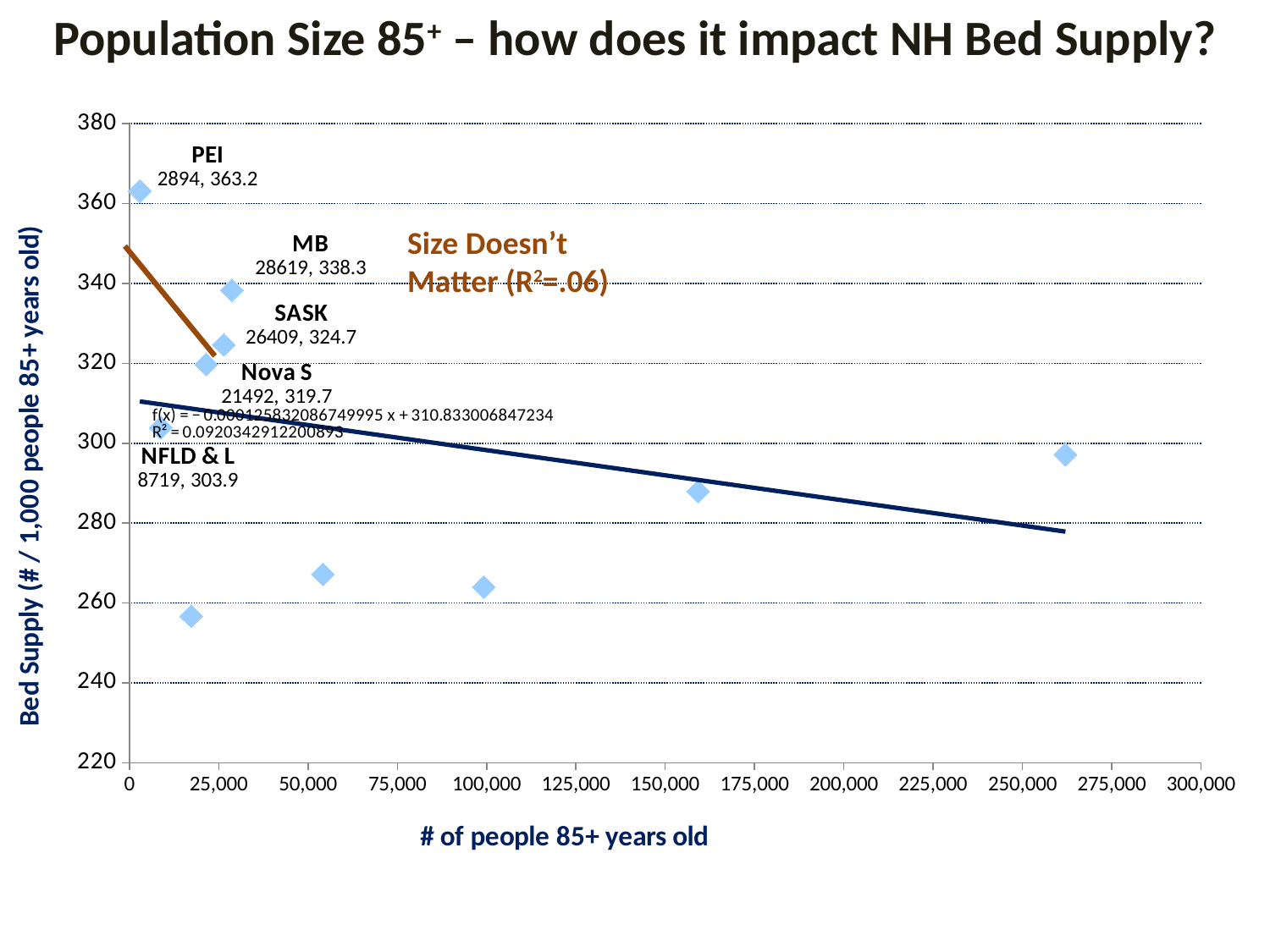
Which has a higher bed supply, SASK or Nova S? SASK Does the dark blue trend line rise or fall as the number of people 85+ increases? fall What is the bed supply value labeled for MB? 338.3 What is the bed supply value labeled for NFLD & L? 303.9 What is the difference in bed supply between MB (338.3) and SASK (324.7)? 13.6 What is the number of people 85+ years old labeled for PEI? 2894 What kind of chart is shown on the slide? scatter chart What is the bed supply value labeled for PEI? 363.2 Is the bed supply for the point at about 262,000 people 85+ greater or less than 280? greater Which labeled province has the highest bed supply? PEI What is the title of the x axis? # of people 85+ years old What is the difference in bed supply between PEI (363.2) and MB (338.3)? 24.9